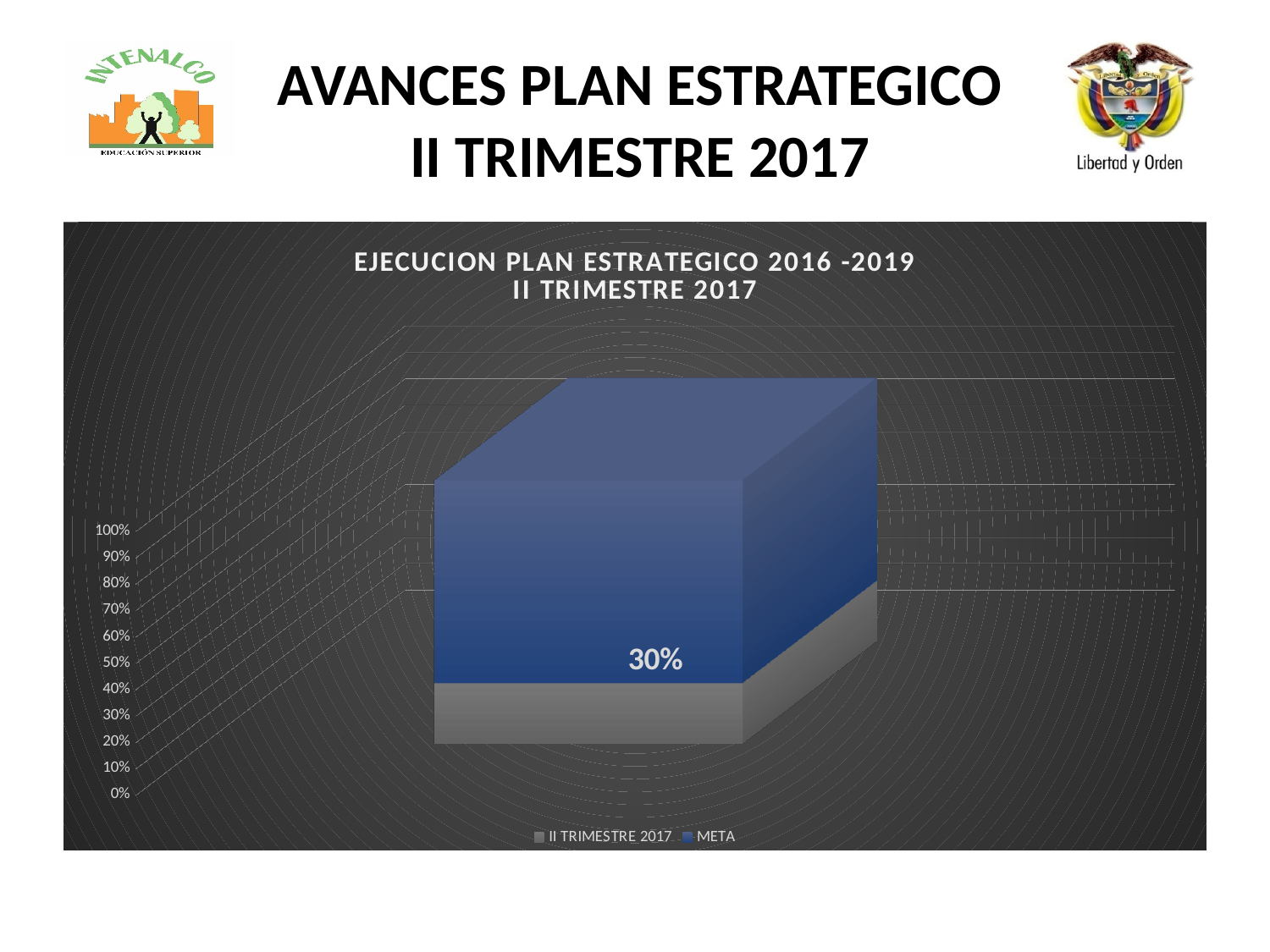
What are the two series named in the chart legend? II TRIMESTRE 2017 and META How many tick labels are shown on the vertical axis of the chart? 11 What is the lowest value shown on the vertical axis of the chart? 0% What is the title of the chart? EJECUCION PLAN ESTRATEGICO 2016 -2019 II TRIMESTRE 2017 What is the highest value shown on the vertical axis of the chart? 100% How many series does the chart legend list? 2 How many bars are plotted in the chart? 1 Which series occupies the larger portion of the stacked bar, META or II TRIMESTRE 2017? META What type of chart is shown on the slide? bar chart What data label value is printed on the bar in the chart? 30%